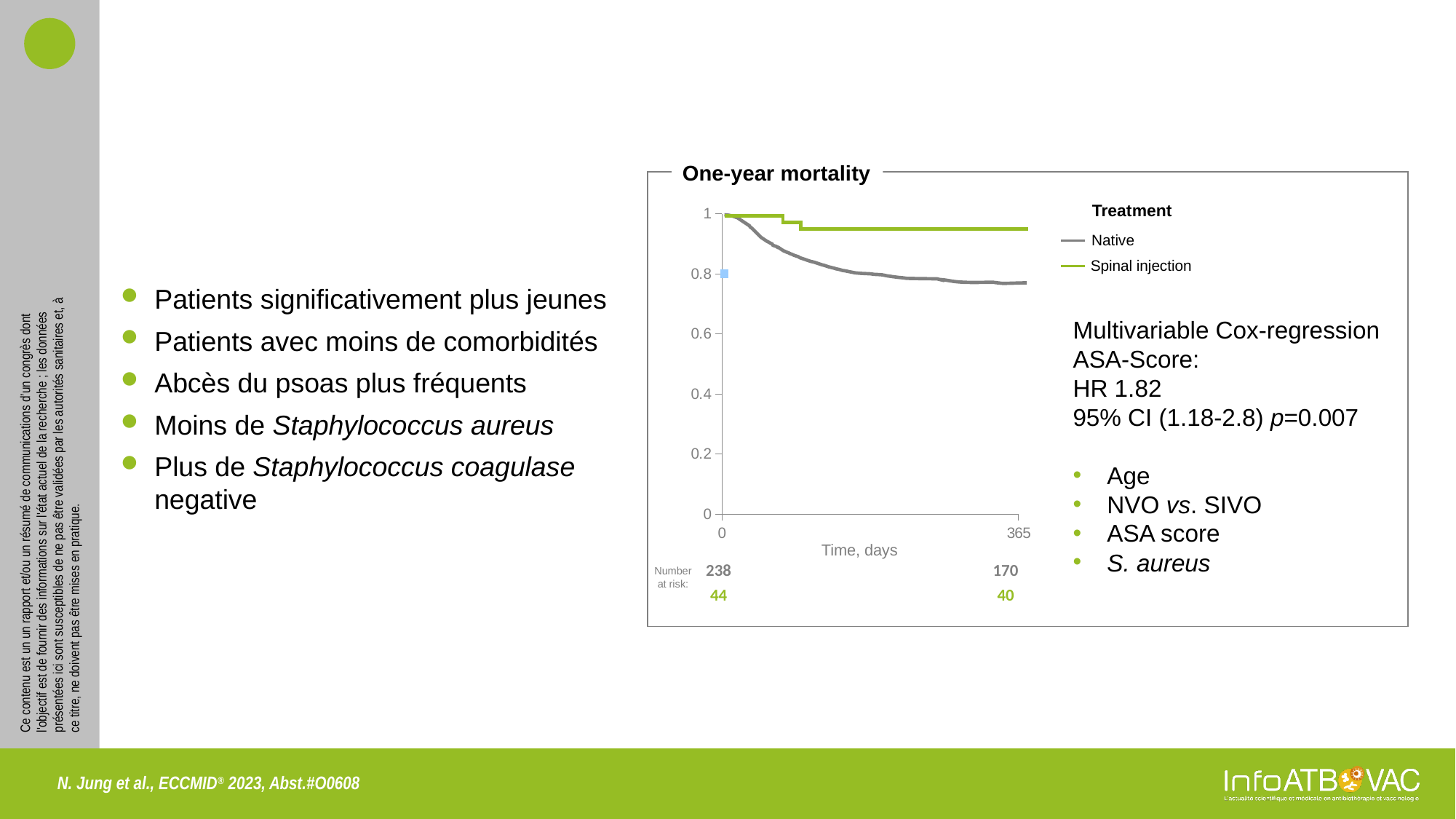
In the "One-year mortality" chart, what is the number at risk for the Native group at day 0? 238 How many treatment groups does the legend of the "One-year mortality" chart list? 2 In the "One-year mortality" chart, by how much does the number at risk for the Spinal injection group decrease between day 0 and day 365? 4 What kind of chart is shown under the title "One-year mortality"? line chart What are the two treatment groups listed in the legend of the "One-year mortality" chart? Native and Spinal injection In the "One-year mortality" chart, by how much does the number at risk for the Native group decrease between day 0 and day 365? 68 What is the label of the x axis of the "One-year mortality" chart? Time, days In the "One-year mortality" chart, what is the number at risk for the Spinal injection group at day 365? 40 Do the curves in the "One-year mortality" chart rise or fall as time increases? fall At day 365, which curve in the "One-year mortality" chart is higher, Native or Spinal injection? Spinal injection At day 365, is the Native curve in the "One-year mortality" chart greater or less than 0.8? less At day 365, is the Spinal injection curve in the "One-year mortality" chart greater or less than 0.8? greater